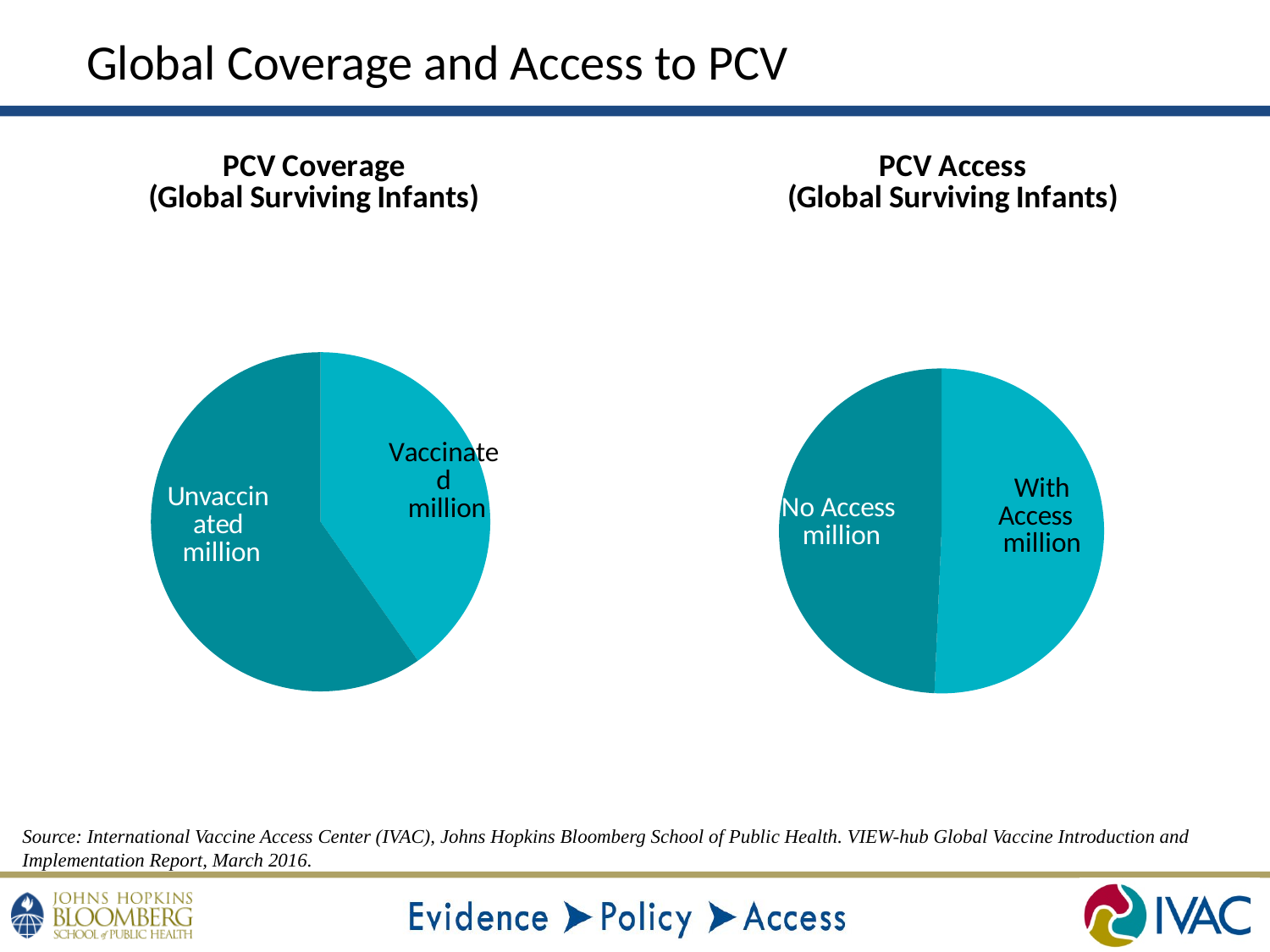
How many slices does the PCV Access (Global Surviving Infants) pie chart have? 2 What kind of chart is the PCV Access (Global Surviving Infants) chart? pie chart How many pie charts are shown on the slide? 2 What kind of chart is the PCV Coverage (Global Surviving Infants) chart? pie chart In the PCV Coverage (Global Surviving Infants) chart, which slice is larger, Vaccinated or Unvaccinated? Unvaccinated In the PCV Coverage (Global Surviving Infants) chart, which slice is the largest? Unvaccinated How many slices does the PCV Coverage (Global Surviving Infants) pie chart have? 2 In the PCV Coverage (Global Surviving Infants) chart, which slice is the smallest? Vaccinated What are the two slice labels in the PCV Access (Global Surviving Infants) chart? No Access and With Access What is the title of the pie chart on the left side of the slide? PCV Coverage (Global Surviving Infants)